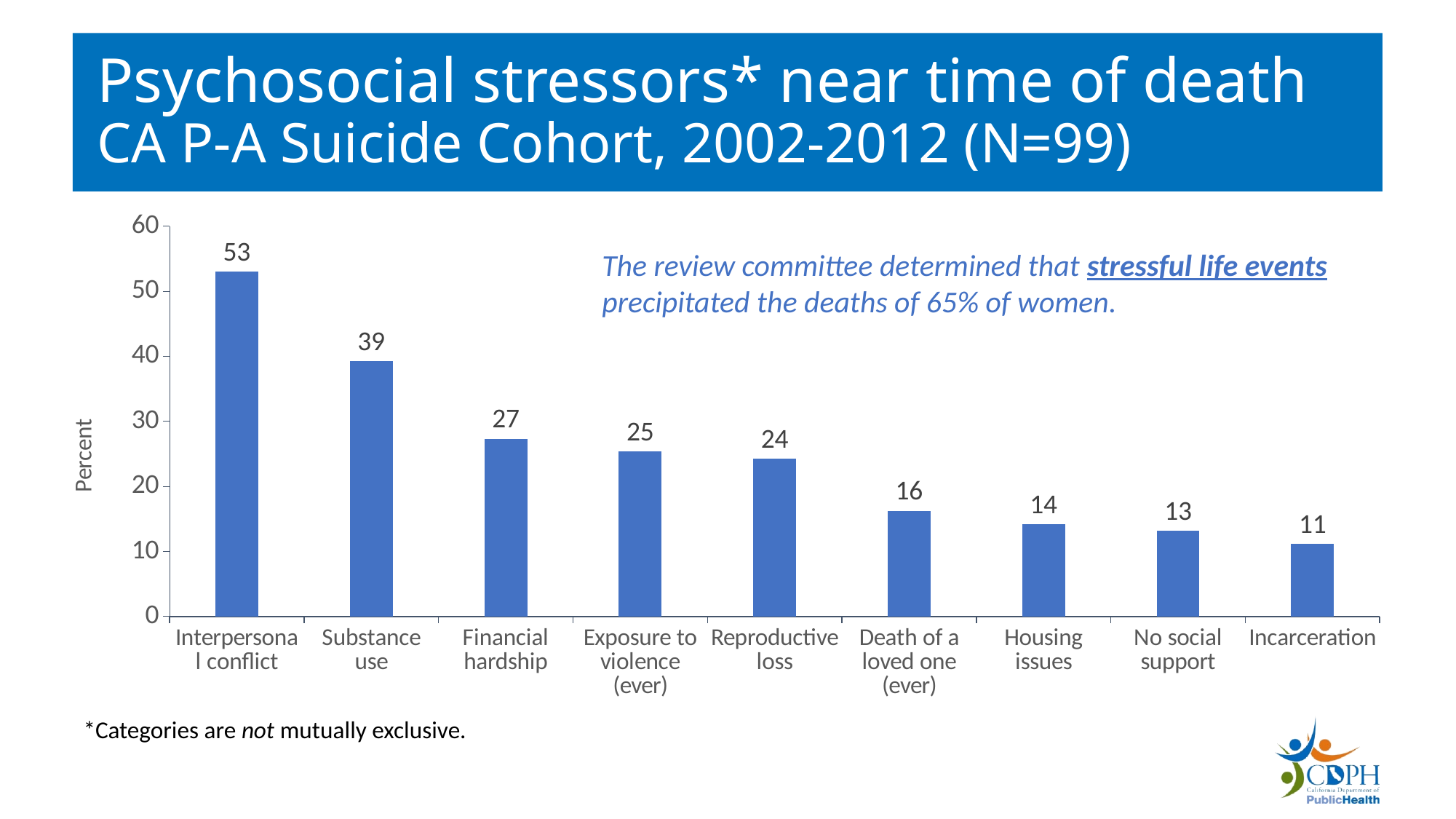
Which psychosocial stressor has the highest percent? Interpersonal conflict Which is larger, the value for Financial hardship or the value for Housing issues? Financial hardship What is the value shown for Incarceration? 11 What kind of chart is shown on the slide? Bar chart What percent of the cohort experienced interpersonal conflict near time of death? 53 What is the difference in percent between Interpersonal conflict and Substance use? 14 How many psychosocial stressor categories are shown on the chart? 9 What is the value shown for Substance use? 39 What is the label on the vertical axis of the chart? Percent Which psychosocial stressor has the lowest percent? Incarceration What is the value shown for Reproductive loss? 24 Is the value for Death of a loved one (ever) greater or less than 20? less